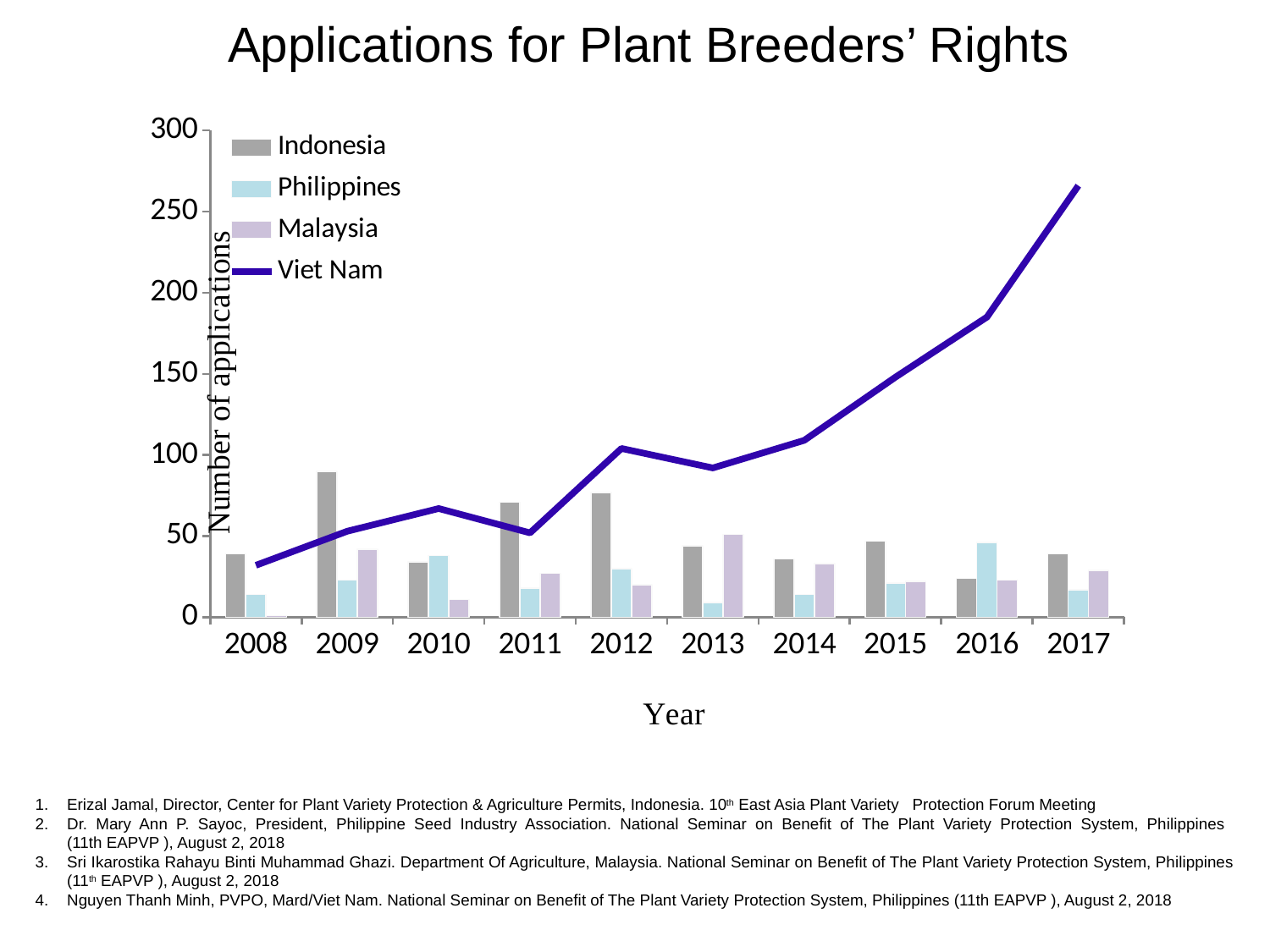
In which year is the Indonesia bar the tallest? 2009 How many series does the legend list? 4 In which year does Viet Nam reach its highest value? 2017 Which series is plotted as a line rather than bars? Viet Nam Does the Viet Nam line generally rise or fall from 2008 to 2017? rise Is the value for Philippines in 2013 greater or less than 50? less What is the label of the y axis? Number of applications Is the value for Indonesia in 2009 greater or less than 50? greater Is the value for Viet Nam in 2008 greater or less than 50? less What kind of chart is this? Combined bar and line chart How many years are shown on the x axis? 10